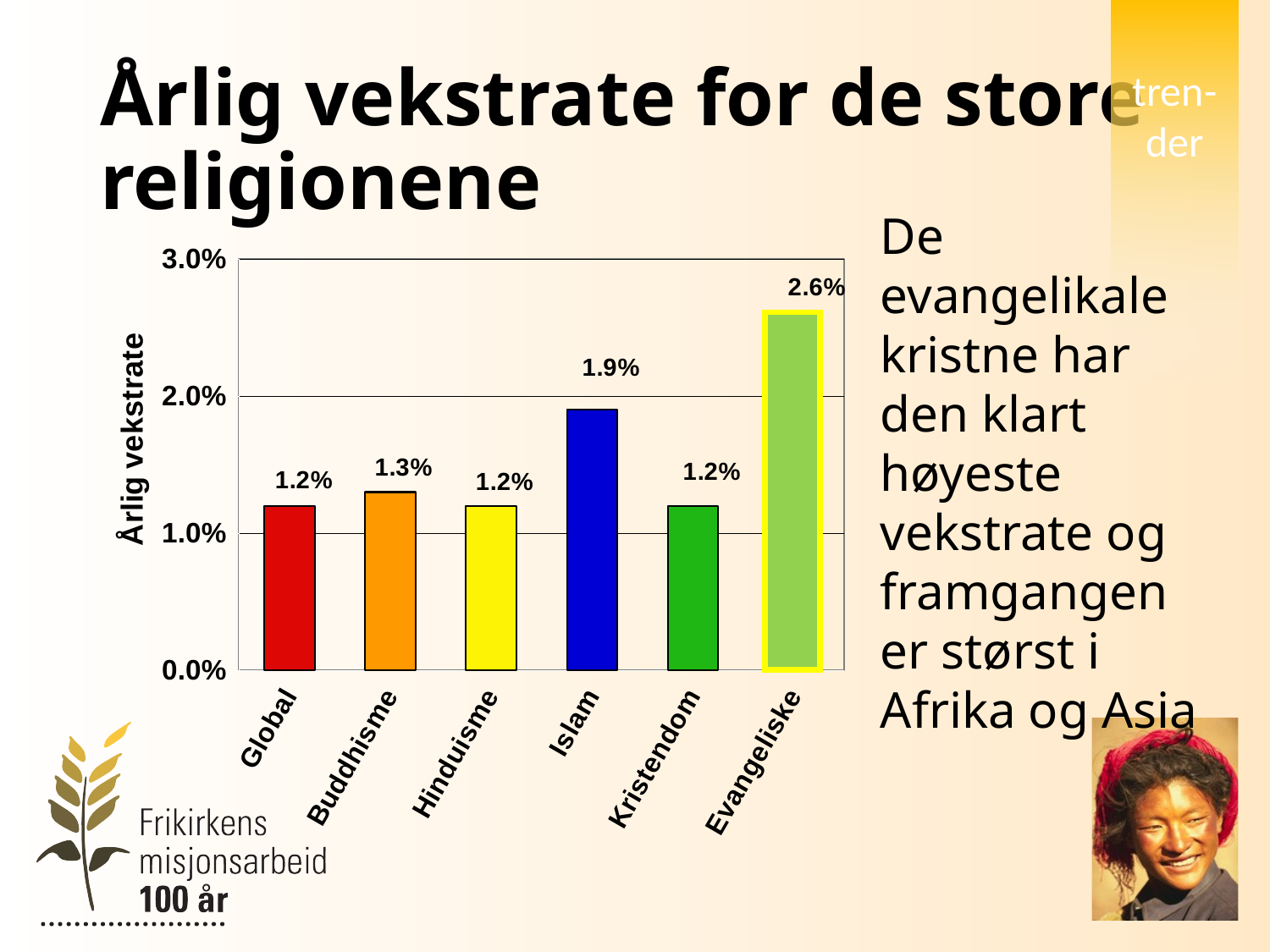
What kind of chart is shown on the slide? bar chart Which has a higher growth rate, Islam or Buddhisme? Islam What is the annual growth rate shown for Global? 1.2% Which category has the highest annual growth rate? Evangeliske What is the label on the vertical axis of the chart? Årlig vekstrate What is the annual growth rate shown for Evangeliske? 2.6% Is the value for Evangeliske greater or less than 2.0%? greater How many categories are shown on the x axis of the chart? 6 What is the difference between the growth rates for Evangeliske and Islam? 0.7% What is the annual growth rate shown for Buddhisme? 1.3% What is the difference between the growth rates for Islam and Kristendom? 0.7% What is the annual growth rate shown for Islam? 1.9%